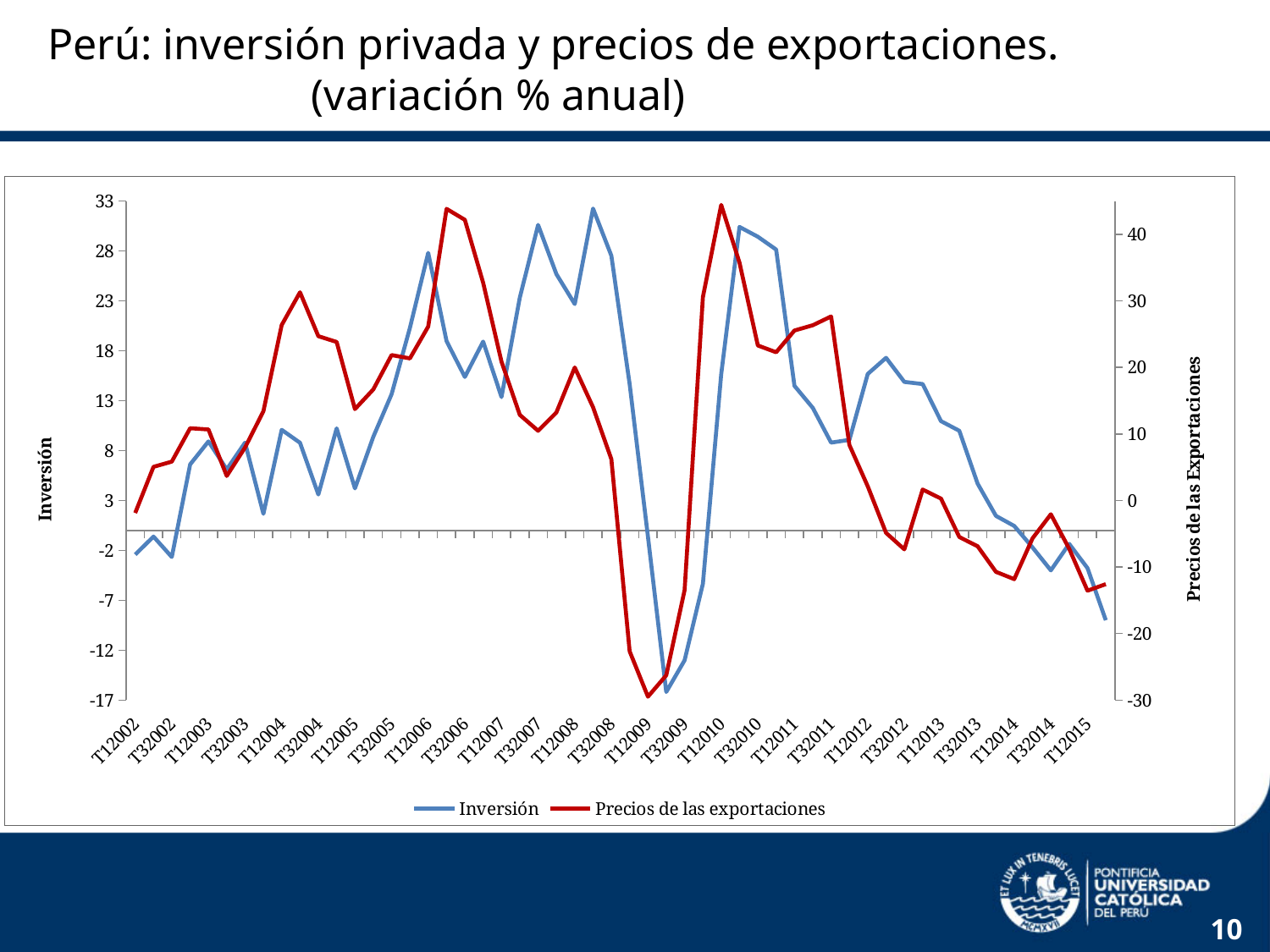
Does the Inversión series generally rise or fall from T12010 to T12015? fall Is the value of Precios de las exportaciones at T12015 greater or less than 0? less What kind of chart is shown on the slide? Line chart In which period does the Precios de las exportaciones series reach its highest value? T12010 Is the value of Inversión at T12015 greater or less than -2? less What is the title of the right-hand vertical axis? Precios de las Exportaciones In which period does the Inversión series reach its lowest value? T22009 How many series does the legend list? 2 Is the value of Precios de las exportaciones at T12010 greater or less than 40? greater Which is larger, the Inversión value at T12006 or at T12002? T12006 What are the two series named in the legend? Inversión and Precios de las exportaciones